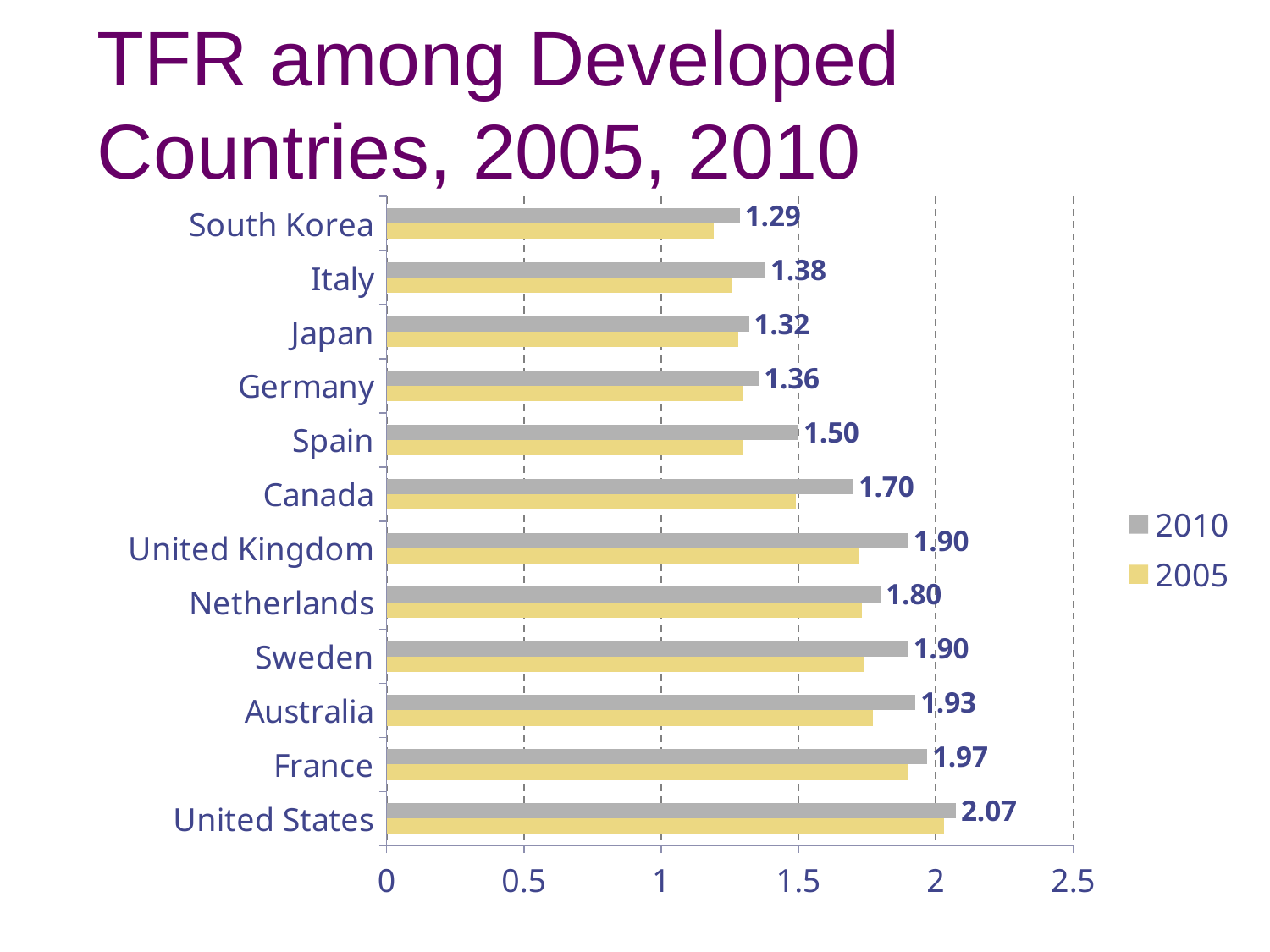
Which country has the lowest 2010 TFR value? South Korea What is the 2010 TFR value for the United States? 2.07 Which colour represents the 2005 series in the legend? yellow How many series does the legend list? 2 Which has the larger 2010 TFR value, France or Australia? France What kind of chart is shown on the slide? bar chart Which country has the highest 2010 TFR value? United States How many countries are shown on the chart? 12 Is the 2005 value for the United Kingdom greater or less than 1.5? greater What is the 2010 TFR value for Spain? 1.50 Is the 2005 value for Spain greater or less than 1.5? less What is the difference between the 2010 TFR values for the United States and South Korea? 0.78